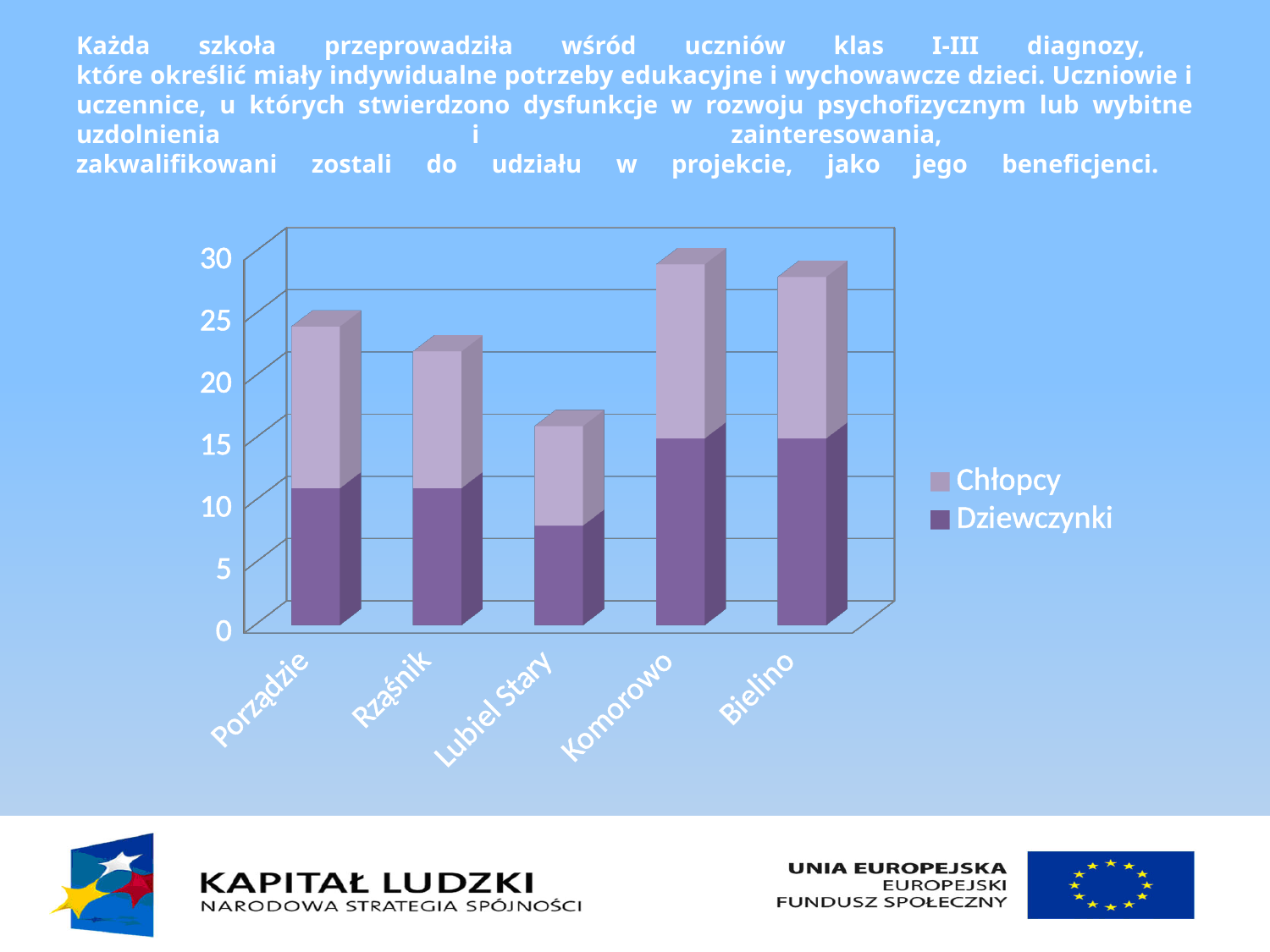
Is the Dziewczynki value for Komorowo greater or less than 10? greater Is the total bar for Lubiel Stary greater or less than 20? less Which school has the lowest Dziewczynki value in the chart? Lubiel Stary How many series does the chart's legend list? 2 Which school has the lowest total bar in the chart? Lubiel Stary Is the total bar for Komorowo greater or less than 25? greater How many categories (schools) are shown on the x axis of the chart? 5 What kind of chart is shown on the slide? stacked bar chart Which has the larger total bar, Komorowo or Rząśnik? Komorowo What are the two series named in the chart's legend? Chłopcy and Dziewczynki Which has the larger total bar, Porządzie or Lubiel Stary? Porządzie